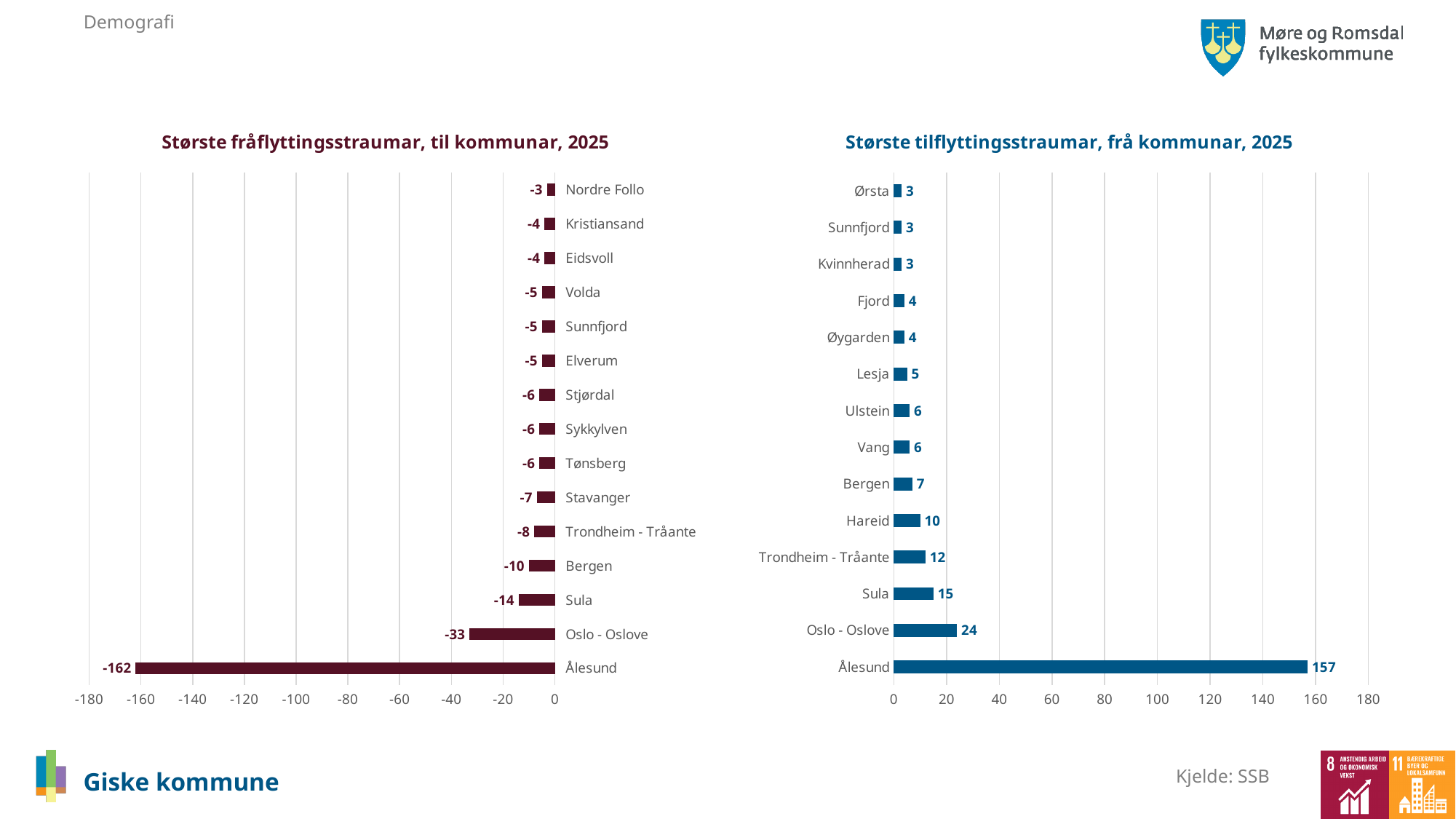
In the chart 'Største tilflyttingsstraumar, frå kommunar, 2025', what is the difference between the values for Ålesund and Oslo - Oslove? 133 In the chart 'Største tilflyttingsstraumar, frå kommunar, 2025', which is larger, the value for Sula or the value for Trondheim - Tråante? Sula What type of chart is 'Største tilflyttingsstraumar, frå kommunar, 2025'? Bar chart In the chart 'Største fråflyttingsstraumar, til kommunar, 2025', what is the difference between the values for Ålesund and Oslo - Oslove? 129 In the chart 'Største tilflyttingsstraumar, frå kommunar, 2025', which municipality has the highest value? Ålesund In the chart 'Største tilflyttingsstraumar, frå kommunar, 2025', what is the value for Ålesund? 157 In the chart 'Største tilflyttingsstraumar, frå kommunar, 2025', what is the value for Hareid? 10 How many municipalities are shown in the chart 'Største fråflyttingsstraumar, til kommunar, 2025'? 15 In the chart 'Største fråflyttingsstraumar, til kommunar, 2025', which municipality has the lowest (most negative) value? Ålesund How many municipalities are shown in the chart 'Største tilflyttingsstraumar, frå kommunar, 2025'? 14 In the chart 'Største fråflyttingsstraumar, til kommunar, 2025', what is the value for Sula? -14 In the chart 'Største fråflyttingsstraumar, til kommunar, 2025', what is the value for Oslo - Oslove? -33